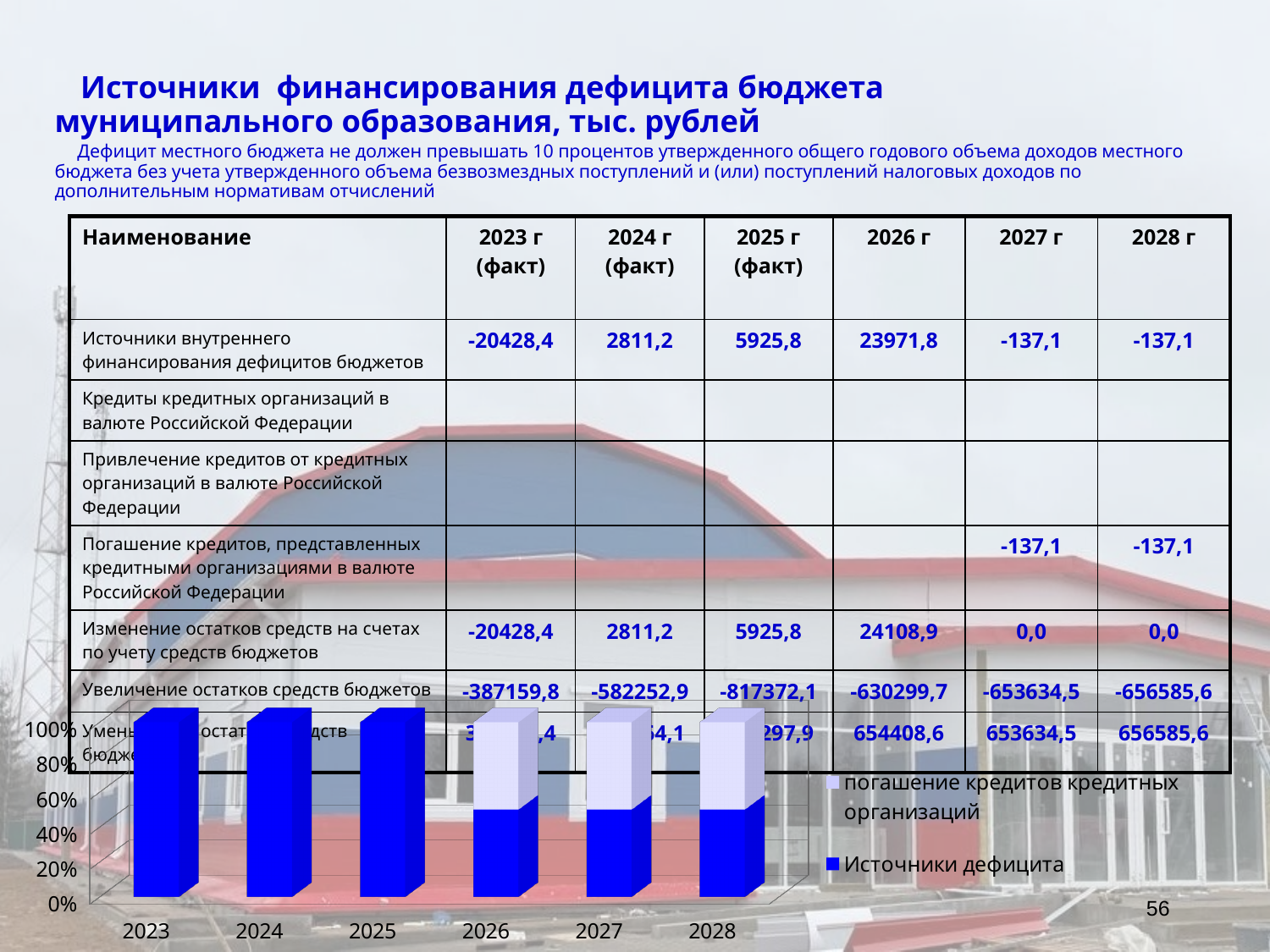
What is the highest tick value shown on the y axis of the bar chart? 100% In the bar chart, is the share for "Источники дефицита" in 2023 greater or less than 80%? greater In the bar chart, is the share for "Источники дефицита" in 2027 greater or less than 80%? less What are the two series named in the legend of the bar chart? погашение кредитов кредитных организаций; Источники дефицита How many series does the legend of the bar chart list? 2 In the bar chart, is the share for "Источники дефицита" in 2025 greater or less than 60%? greater What is the first year shown on the x axis of the bar chart? 2023 How many years (categories) are shown on the x axis of the bar chart? 6 What kind of chart is shown at the bottom of the slide? bar chart Which series in the bar chart is shown in dark blue? Источники дефицита In the bar chart, which is larger: the "Источники дефицита" share in 2024 or in 2026? 2024